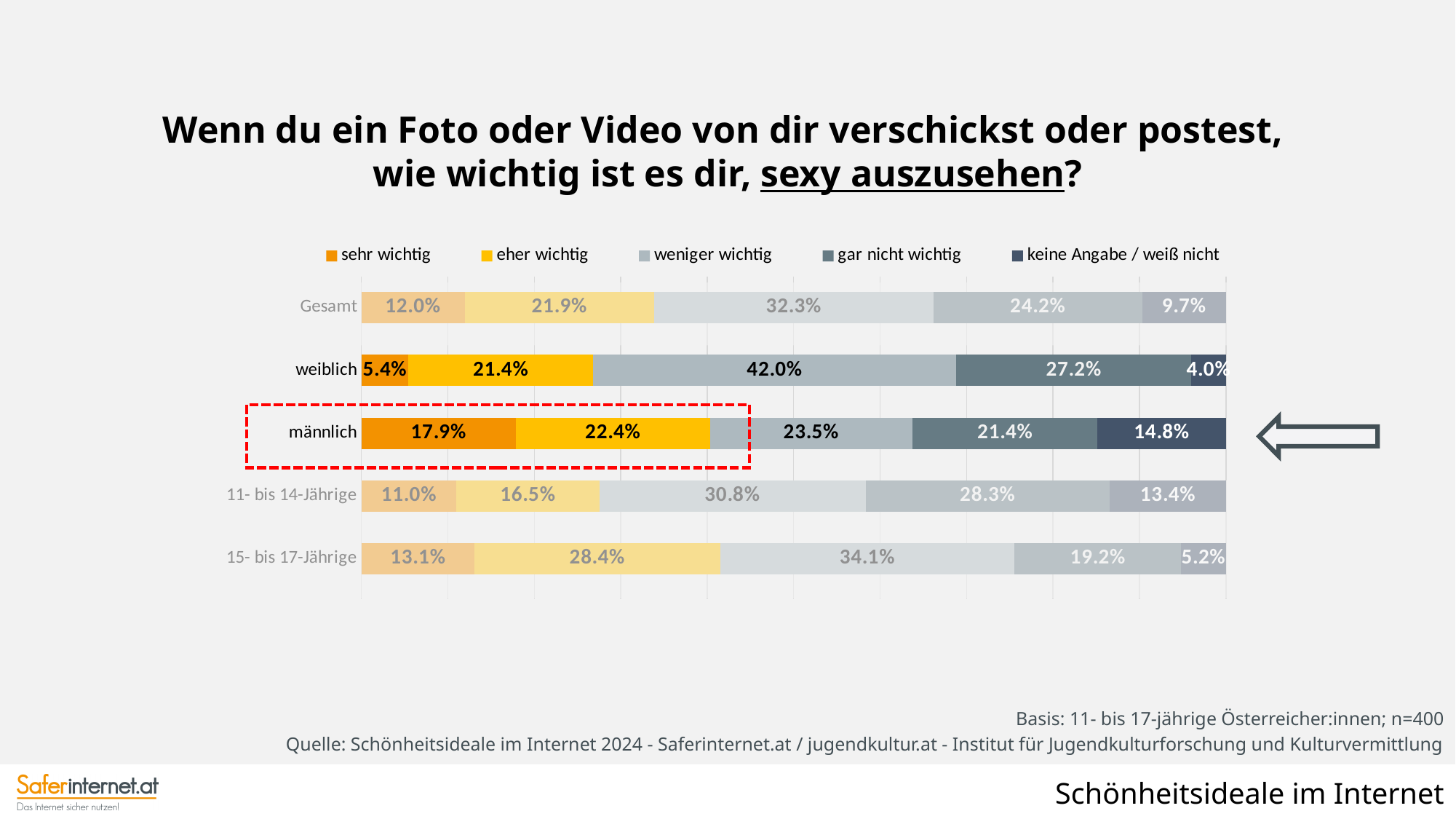
What is the "weniger wichtig" value for the weiblich group? 42.0% Which group has the larger "eher wichtig" share: 11- bis 14-Jährige or 15- bis 17-Jährige? 15- bis 17-Jährige Which group has the lowest "sehr wichtig" share? weiblich How many percentage points higher is the "sehr wichtig" share for männlich than for weiblich? 12.5 percentage points What is the total of all segments in the männlich bar? 100.0% How many series does the legend list? 5 What percentage of männlich respondents answered "sehr wichtig"? 17.9% What is the "keine Angabe / weiß nicht" value for 15- bis 17-Jährige? 5.2% How many groups (bars) are shown in the chart? 5 Which group's bar is highlighted with a red dashed box and an arrow? männlich What kind of chart is shown on the slide? Stacked bar chart Which group has the highest "sehr wichtig" share? männlich